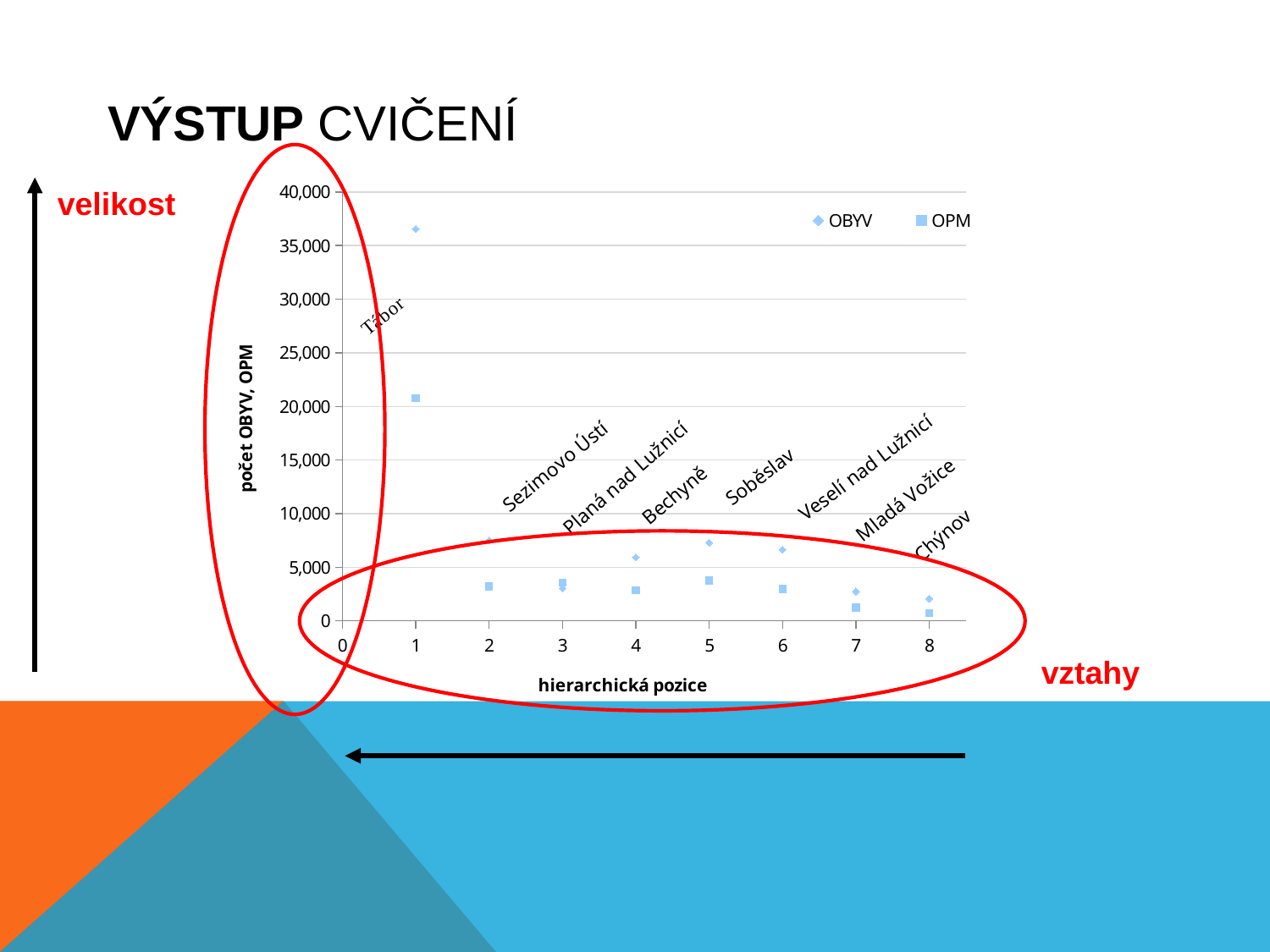
Is the OBYV value at hierarchical position 1 greater or less than 35,000? greater At which hierarchical position is the OBYV value highest? 1 At hierarchical position 1, which series has the larger value, OBYV or OPM? OBYV Is the OBYV value at hierarchical position 5 greater or less than 5,000? greater What is the title of the x axis? hierarchická pozice Is the OPM value at hierarchical position 1 greater or less than 20,000? greater How many series does the legend list? 2 What kind of chart is shown on the slide? scatter chart Which has the larger OBYV value, hierarchical position 2 or hierarchical position 7? position 2 What are the two series named in the legend? OBYV and OPM How many hierarchical positions have data points plotted? 8